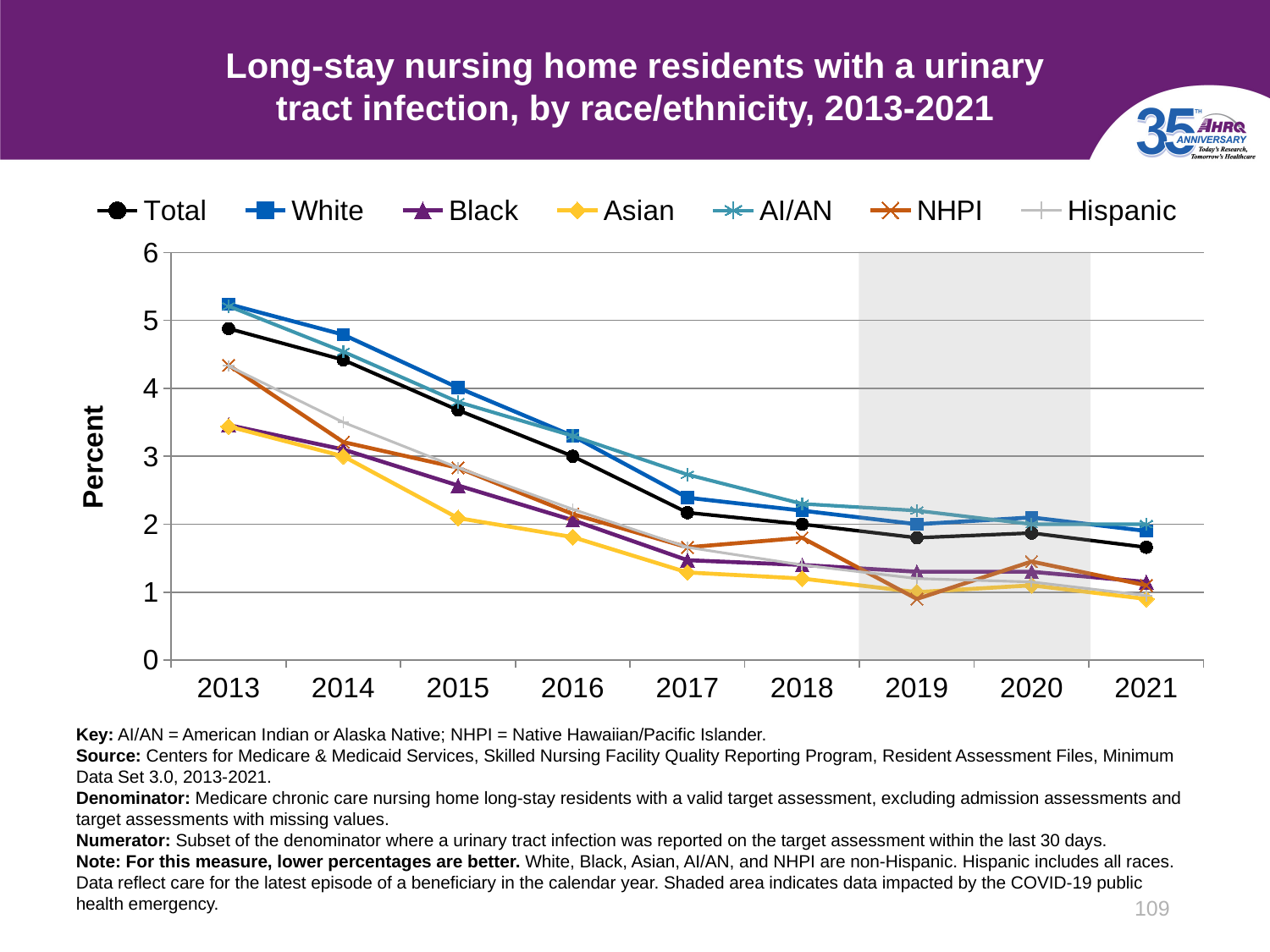
Does the Total line rise or fall from 2013 to 2021? Fall Is the value for Asian in 2015 greater or less than 3? less What kind of chart is shown on the slide? Line chart What is the label on the y axis? Percent In 2013, which is larger, the value for White or the value for Asian? White Is the value for White in 2013 greater or less than 5? greater Is the value for AI/AN in 2018 greater or less than 2? greater Which group has the lowest value in 2016? Asian Which group has the highest value in 2017? AI/AN How many series does the legend list? 7 How many years are shown on the x axis? 9